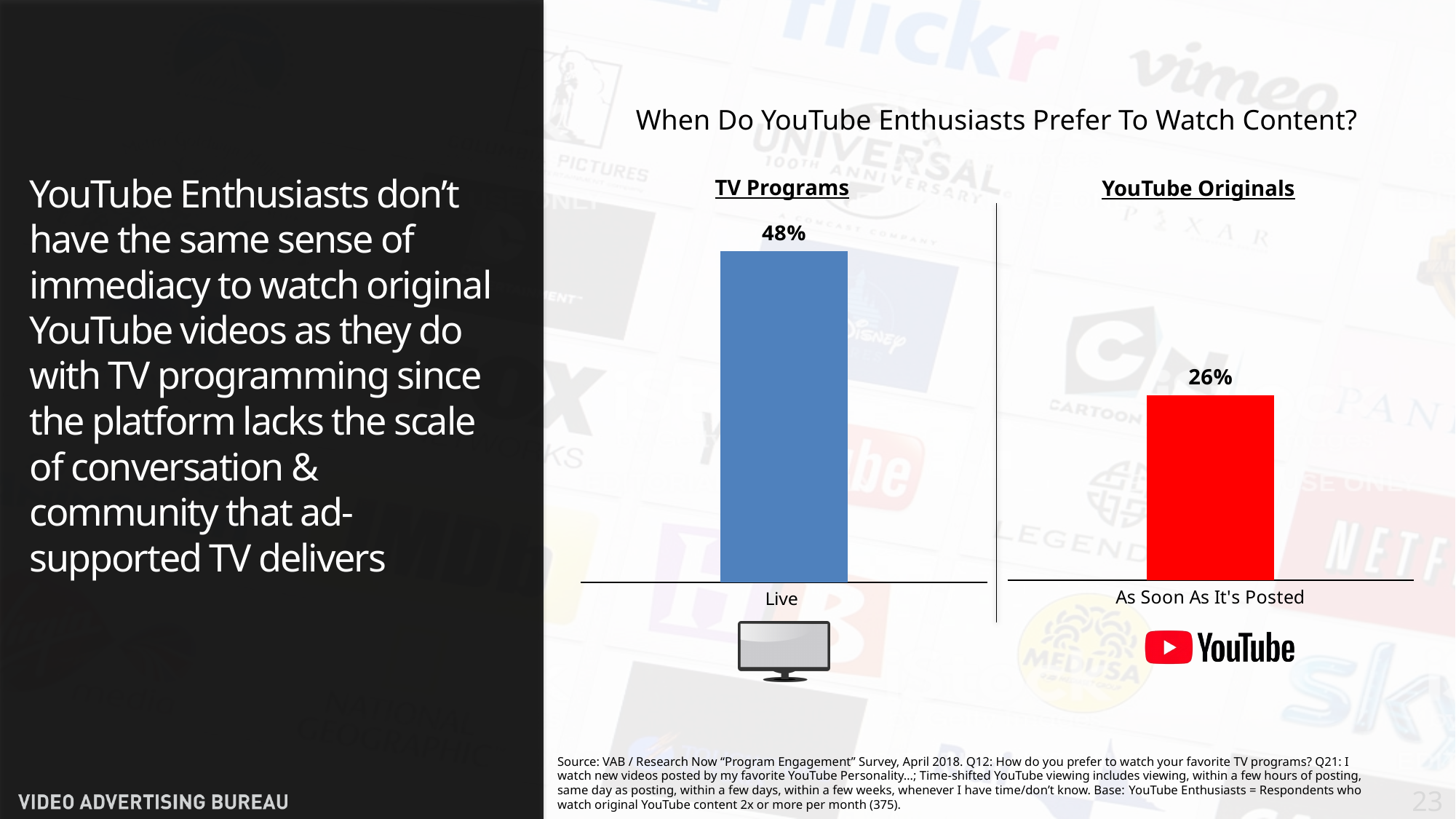
Which is larger: the Live value in the TV Programs chart or the As Soon As It's Posted value in the YouTube Originals chart? Live (TV Programs) What is the title shown above the two charts? When Do YouTube Enthusiasts Prefer To Watch Content? How many bars are plotted in the TV Programs chart? 1 What is the category label of the bar in the YouTube Originals chart? As Soon As It's Posted Is the value for Live in the TV Programs chart greater or less than 40%? greater What kind of chart is the TV Programs chart? Bar chart In the YouTube Originals chart, what is the value for As Soon As It's Posted? 26% How many bars are plotted in the YouTube Originals chart? 1 What kind of chart is the YouTube Originals chart? Bar chart In the TV Programs chart, what is the value for Live? 48% What is the difference between the Live value in the TV Programs chart and the As Soon As It's Posted value in the YouTube Originals chart? 22% Is the value for As Soon As It's Posted in the YouTube Originals chart greater or less than 30%? less